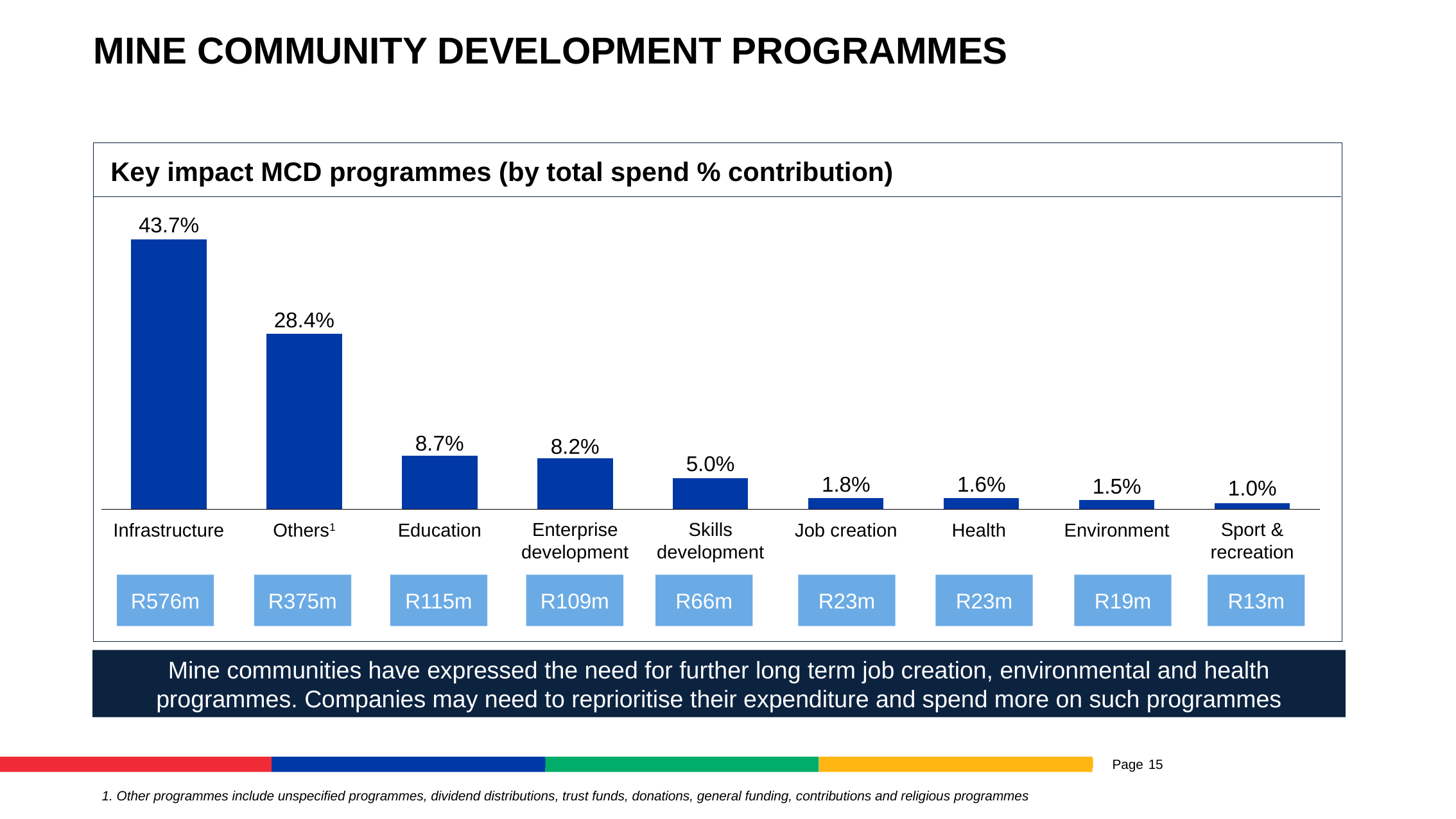
Do the values rise or fall from left to right across the categories? Fall What is the rand amount shown for Job creation? R23m How many categories are shown in the chart? 9 What is the title of the chart? Key impact MCD programmes (by total spend % contribution) What is the rand amount shown below the Education bar? R115m What is the difference in percentage points between Infrastructure and Others? 15.3 What percentage contribution is shown for Skills development? 5.0% Which category has the highest percentage contribution? Infrastructure What percentage contribution is shown for Infrastructure? 43.7% What kind of chart is shown on the slide? Bar chart Which has a larger percentage contribution, Education or Enterprise development? Education Which category has the lowest percentage contribution? Sport & recreation